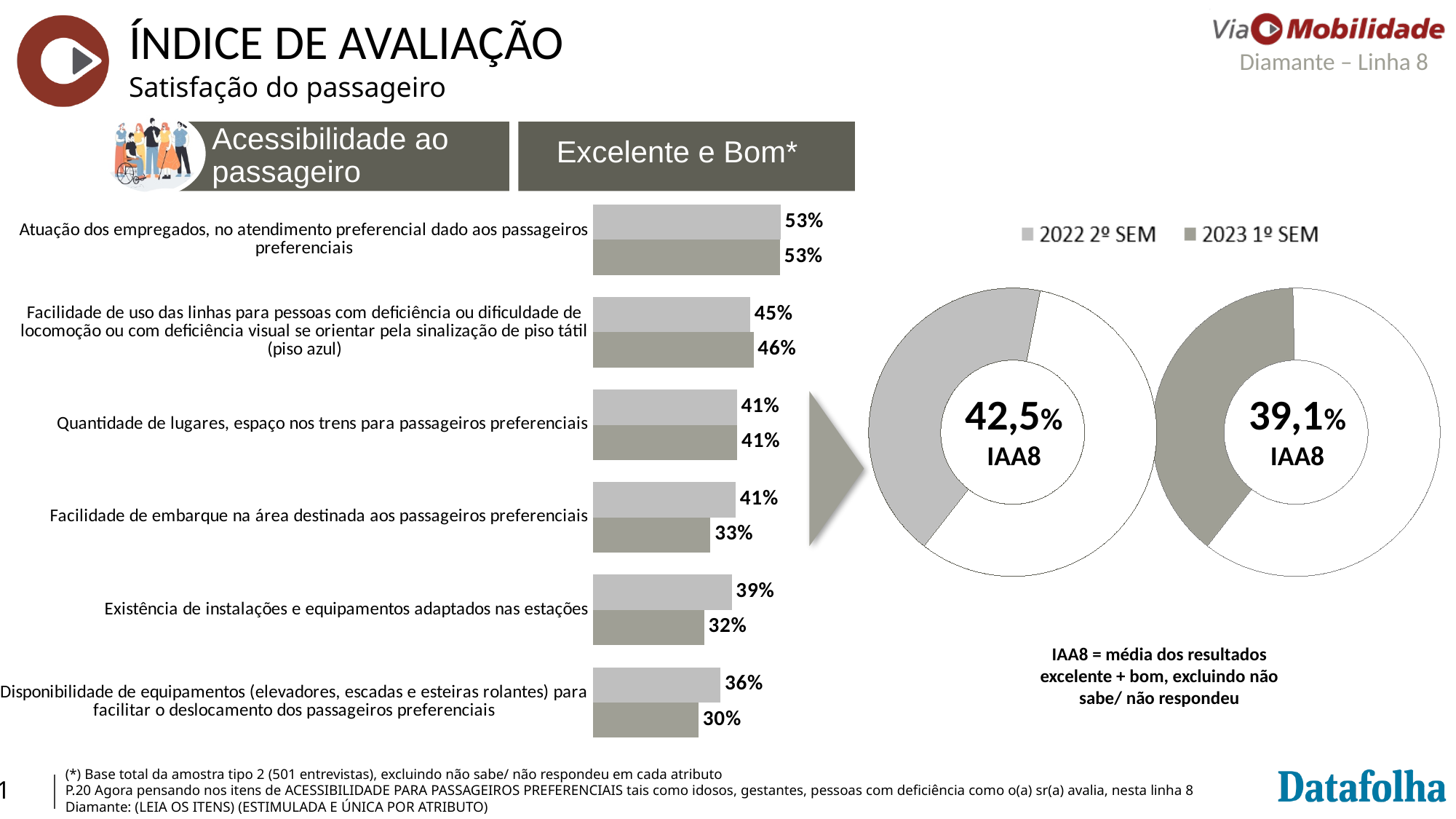
How many series does the legend list? 2 How many attributes (categories) are shown in the bar chart? 6 In the bar chart, what is the 2023 1º SEM value for 'Disponibilidade de equipamentos (elevadores, escadas e esteiras rolantes) para facilitar o deslocamento dos passageiros preferenciais'? 30% In the bar chart, what is the difference between the 2022 2º SEM and 2023 1º SEM values for 'Facilidade de embarque na área destinada aos passageiros preferenciais'? 8 percentage points In the bar chart, which attribute has the lowest value for 2022 2º SEM? Disponibilidade de equipamentos (elevadores, escadas e esteiras rolantes) para facilitar o deslocamento dos passageiros preferenciais In the bar chart, for 'Facilidade de uso das linhas para pessoas com deficiência ou dificuldade de locomoção ou com deficiência visual se orientar pela sinalização de piso tátil (piso azul)', which period has the higher value? 2023 1º SEM What is the difference between the IAA8 values shown in the two donut charts (2022 2º SEM minus 2023 1º SEM)? 3,4 percentage points In the bar chart, what is the 2023 1º SEM value for 'Facilidade de embarque na área destinada aos passageiros preferenciais'? 33% In the donut chart for 2022 2º SEM, what is the IAA8 value shown in the centre? 42,5% In the bar chart, which attribute has the highest value for 2023 1º SEM? Atuação dos empregados, no atendimento preferencial dado aos passageiros preferenciais In the bar chart, what is the 2022 2º SEM value for 'Existência de instalações e equipamentos adaptados nas estações'? 39% What kind of chart is used to show the attribute values on the left side of the slide? Bar chart